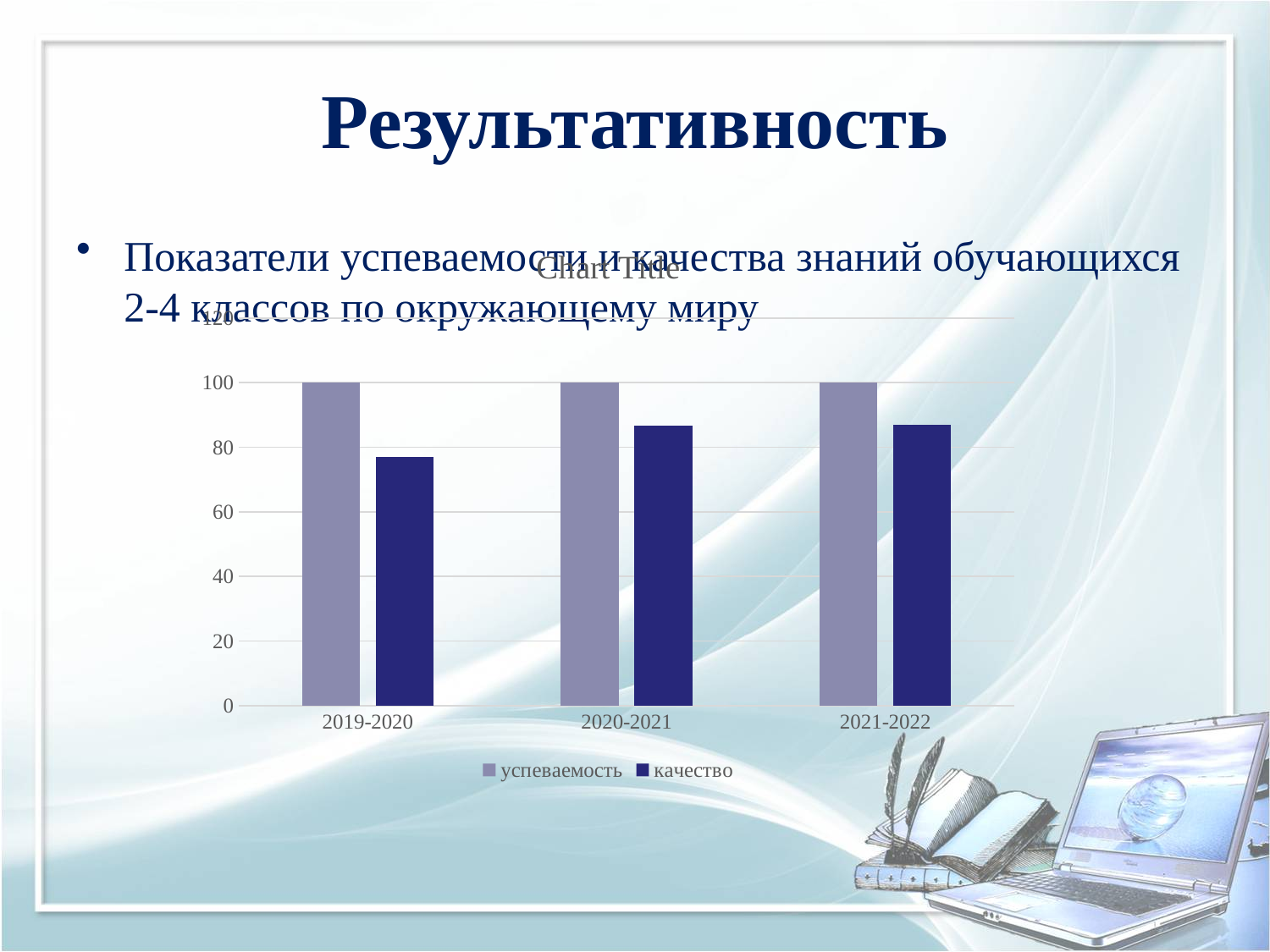
Does the value of качество rise or fall from 2019-2020 to 2021-2022? rise What are the two series named in the chart legend? успеваемость and качество Is the value of качество for 2019-2020 greater or less than 80? less Is the value of качество for 2021-2022 greater or less than 100? less What is the value of успеваемость for 2019-2020? 100 Which is larger: качество for 2019-2020 or качество for 2020-2021? 2020-2021 What kind of chart is shown on the slide? bar chart What is the value of успеваемость for 2021-2022? 100 Which category has the lowest value of качество? 2019-2020 Is the value of качество for 2020-2021 greater or less than 80? greater How many series does the chart legend list? 2 How many categories are shown on the x axis of the chart? 3